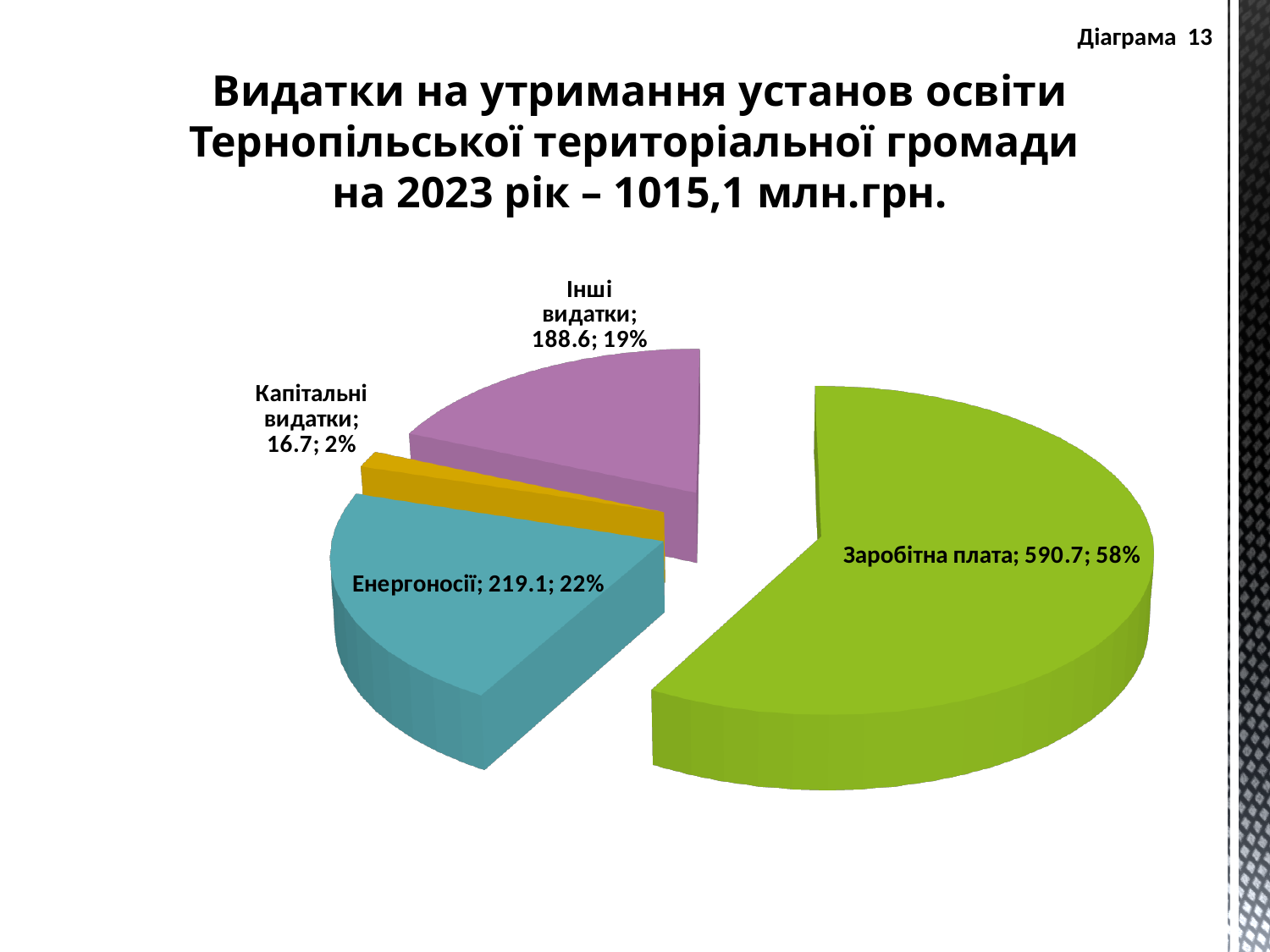
What is the value for Заробітна плата? 590.7 What share of the pie does Енергоносії represent? 22% How many slices does the pie chart have? 4 What kind of chart is shown on the slide? pie chart What is the value for Енергоносії? 219.1 What is the value for Капітальні видатки? 16.7 What is the difference between the values for Енергоносії and Інші видатки? 30.5 Which is larger, the value for Інші видатки or the value for Капітальні видатки? Інші видатки What is the value for Інші видатки? 188.6 Which category has the largest slice? Заробітна плата Which category has the smallest slice? Капітальні видатки What share of the pie does Заробітна плата represent? 58%